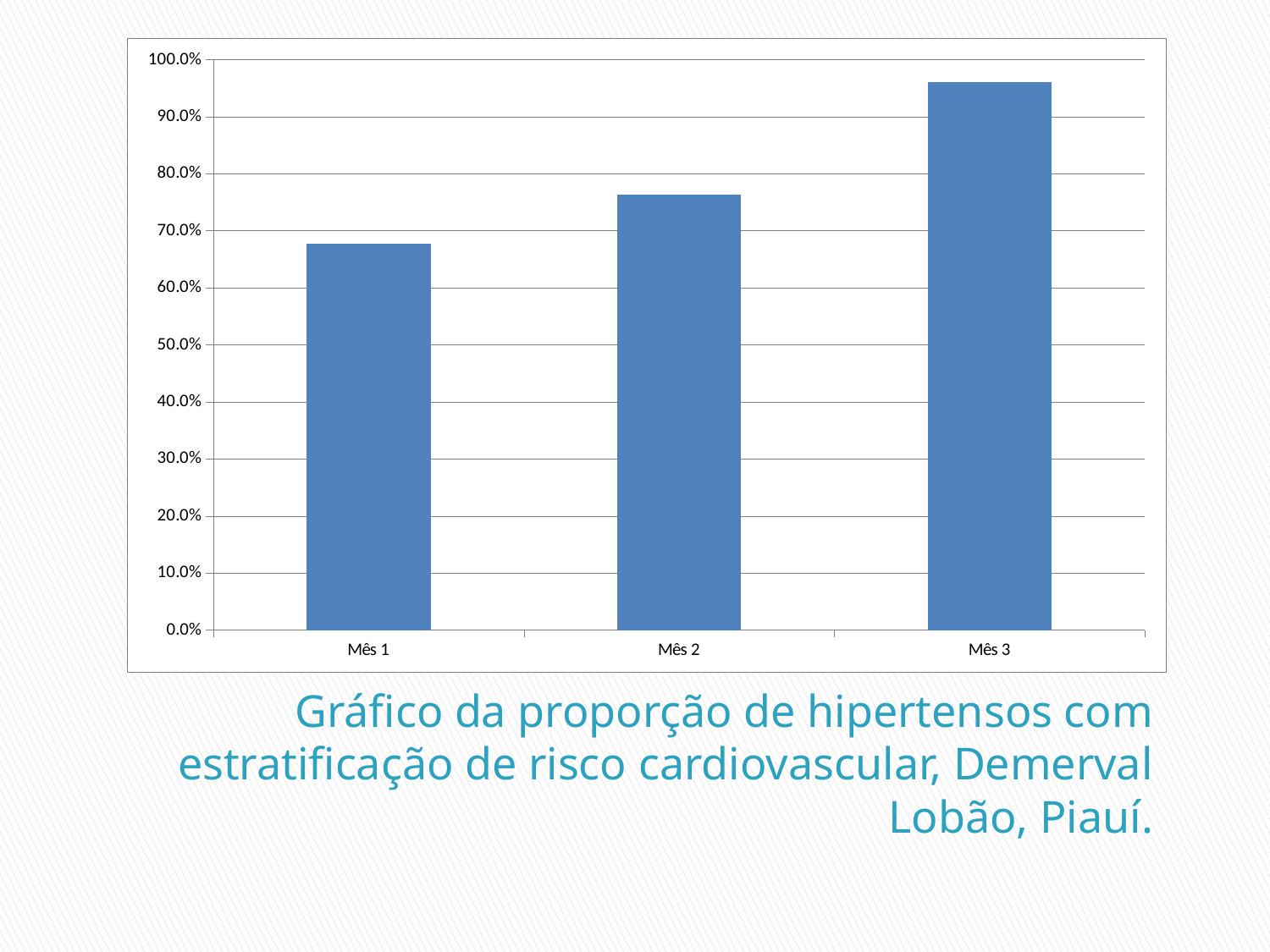
Is the value for Mês 2 greater or less than 70.0%? greater What is the maximum value shown on the vertical axis? 100.0% Is the value for Mês 1 greater or less than 70.0%? less Is the value for Mês 2 greater or less than 80.0%? less Do the values rise or fall from Mês 1 to Mês 3? rise How many categories (months) are plotted on the chart? 3 Which month has the lowest value on the chart? Mês 1 Which month has the highest value on the chart? Mês 3 What kind of chart is shown on the slide? Bar chart According to the caption, which municipality does the chart refer to? Demerval Lobão, Piauí Which is larger, the value for Mês 1 or the value for Mês 2? Mês 2